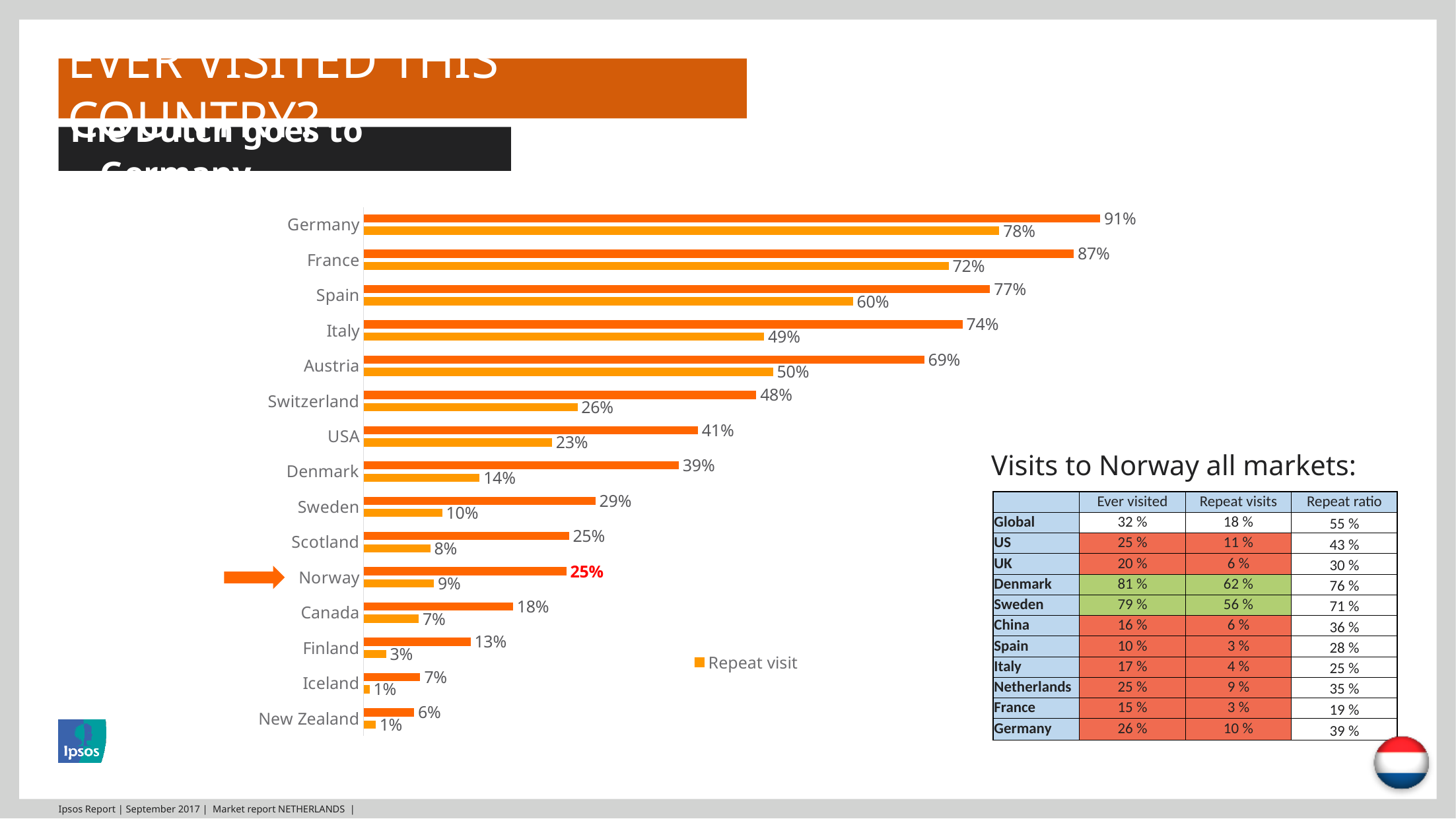
In the bar chart, what is the value of the upper (darker orange) bar for Norway, highlighted in red? 25% What type of chart is used to show the visited-country data? Bar chart In the bar chart, what is the difference between the two bars shown for Norway (25% and 9%)? 16 percentage points Which country has the lowest value for the upper (darker orange) bar in the bar chart? New Zealand Which country has the highest Repeat visit value in the bar chart? Germany In the bar chart, what is the difference between the Repeat visit values for Germany and France? 6 percentage points In the bar chart, which is larger: the Repeat visit value for Spain or for Italy? Spain What is the only series name shown in the bar chart's legend? Repeat visit How many countries are listed on the bar chart? 15 In the bar chart, what is the Repeat visit value for Norway? 9% In the bar chart, what is the Repeat visit value for Germany? 78% In the bar chart, what is the value of the upper (darker orange) bar for Switzerland? 48%